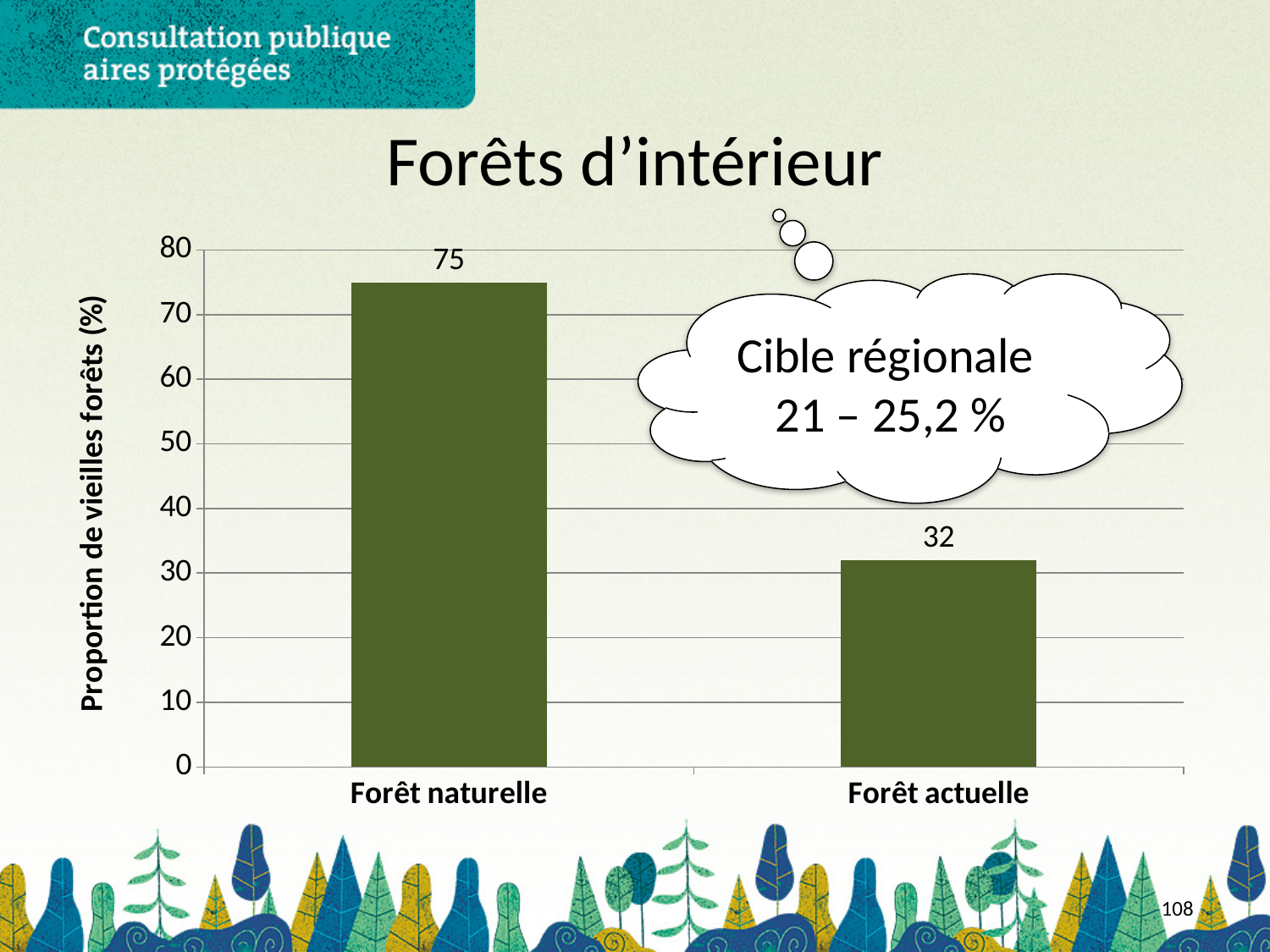
Which category has the lowest value? Forêt actuelle Which is larger, the value for Forêt naturelle or Forêt actuelle? Forêt naturelle What kind of chart is shown on the slide? bar chart Is the value for Forêt naturelle greater or less than 70? greater Is the value for Forêt actuelle greater or less than 40? less Which category has the highest value? Forêt naturelle What is the difference between the values for Forêt naturelle and Forêt actuelle? 43 How many categories are shown in the chart? 2 What is the title of the chart? Forêts d'intérieur What is the value for Forêt naturelle? 75 What is the label of the vertical axis? Proportion de vieilles forêts (%) What is the value for Forêt actuelle? 32